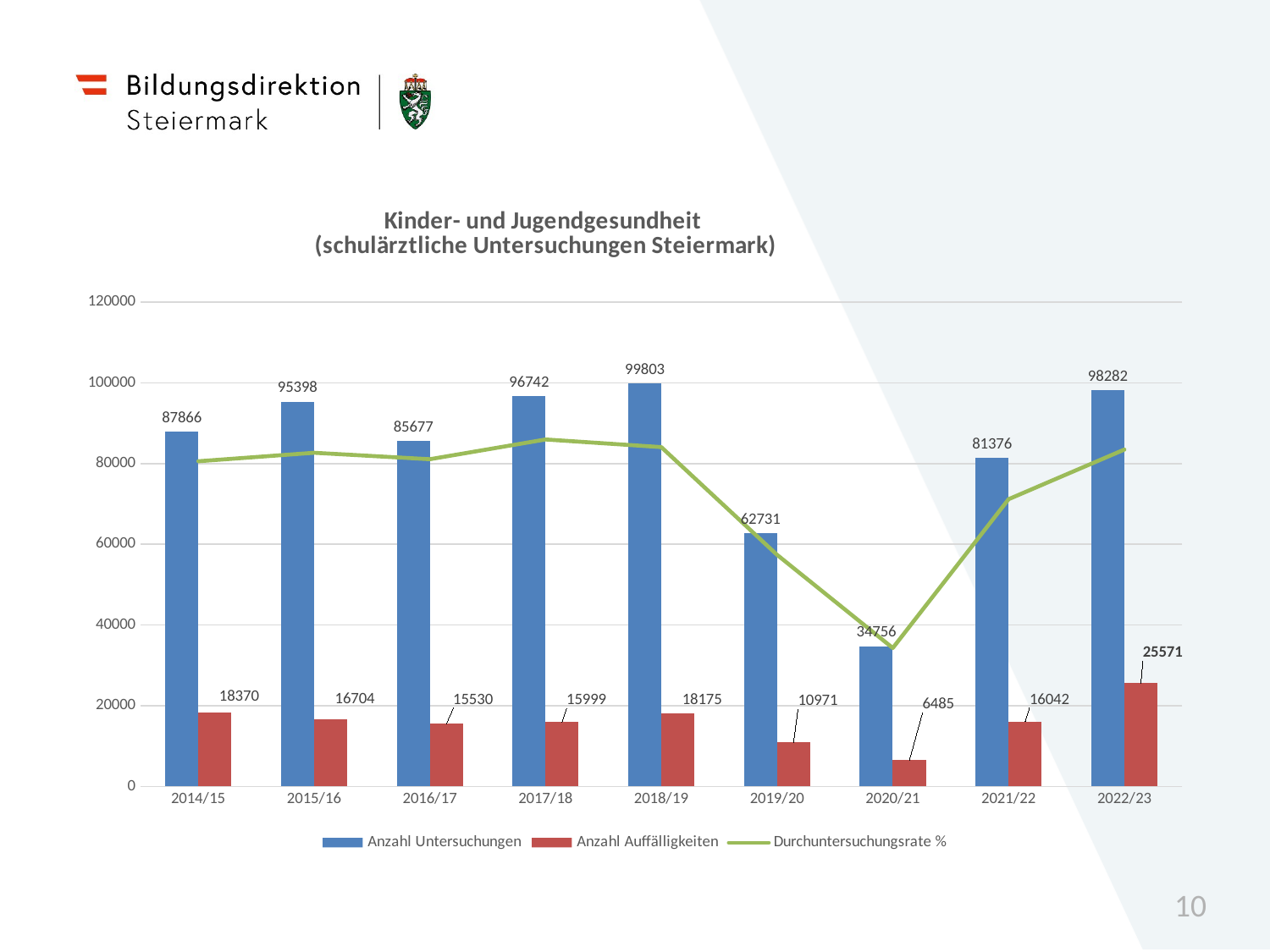
What is the value of Anzahl Untersuchungen for 2018/19? 99803 Which is larger, Anzahl Untersuchungen in 2015/16 or in 2016/17? 2015/16 How many series does the legend list? 3 What kind of chart is this? bar chart with a line How many school years are shown on the x axis? 9 What is the value of Anzahl Untersuchungen for 2020/21? 34756 Is the value of the Durchuntersuchungsrate % line for 2020/21 greater or less than 40000 on the axis? less Which school year has the lowest Anzahl Auffälligkeiten? 2020/21 Does Anzahl Untersuchungen rise or fall from 2018/19 to 2020/21? fall Which school year has the highest Anzahl Untersuchungen? 2018/19 What is the value of Anzahl Auffälligkeiten for 2022/23? 25571 What is the difference between Anzahl Untersuchungen in 2018/19 and in 2020/21? 65047